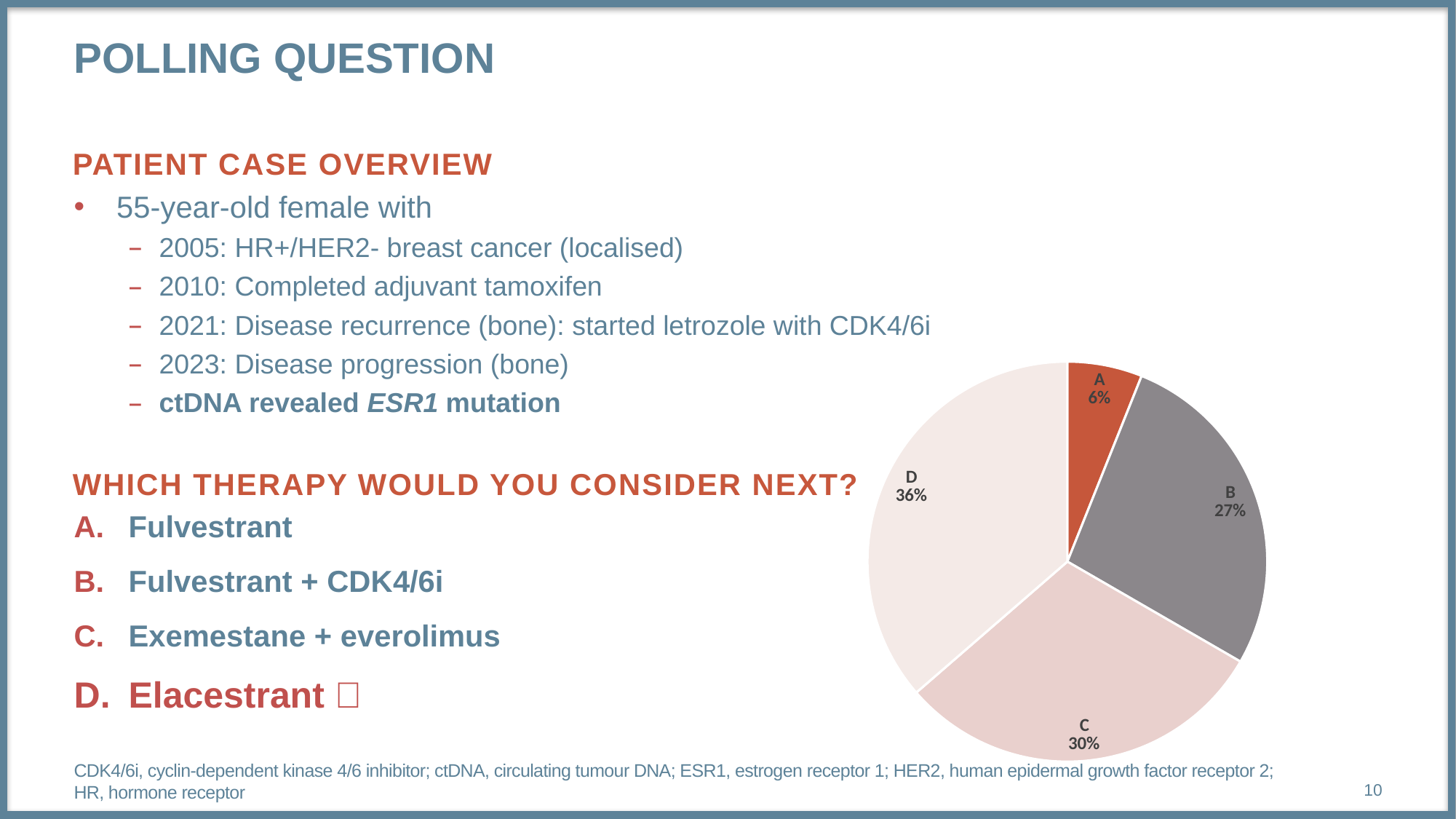
What percentage is shown for slice C in the pie chart? 30% What percentage is shown for slice B in the pie chart? 27% What is the combined share of slices A and B in the pie chart? 33% What is the difference in percentage points between slice D and slice B? 9 What kind of chart is shown on the slide? pie chart Which slice of the pie chart is the smallest? A Which slice of the pie chart is the largest? D What percentage is shown for slice D in the pie chart? 36% How many slices does the pie chart have? 4 What colour is slice A in the pie chart? orange-red Which is larger in the pie chart, slice B or slice C? C What percentage is shown for slice A in the pie chart? 6%